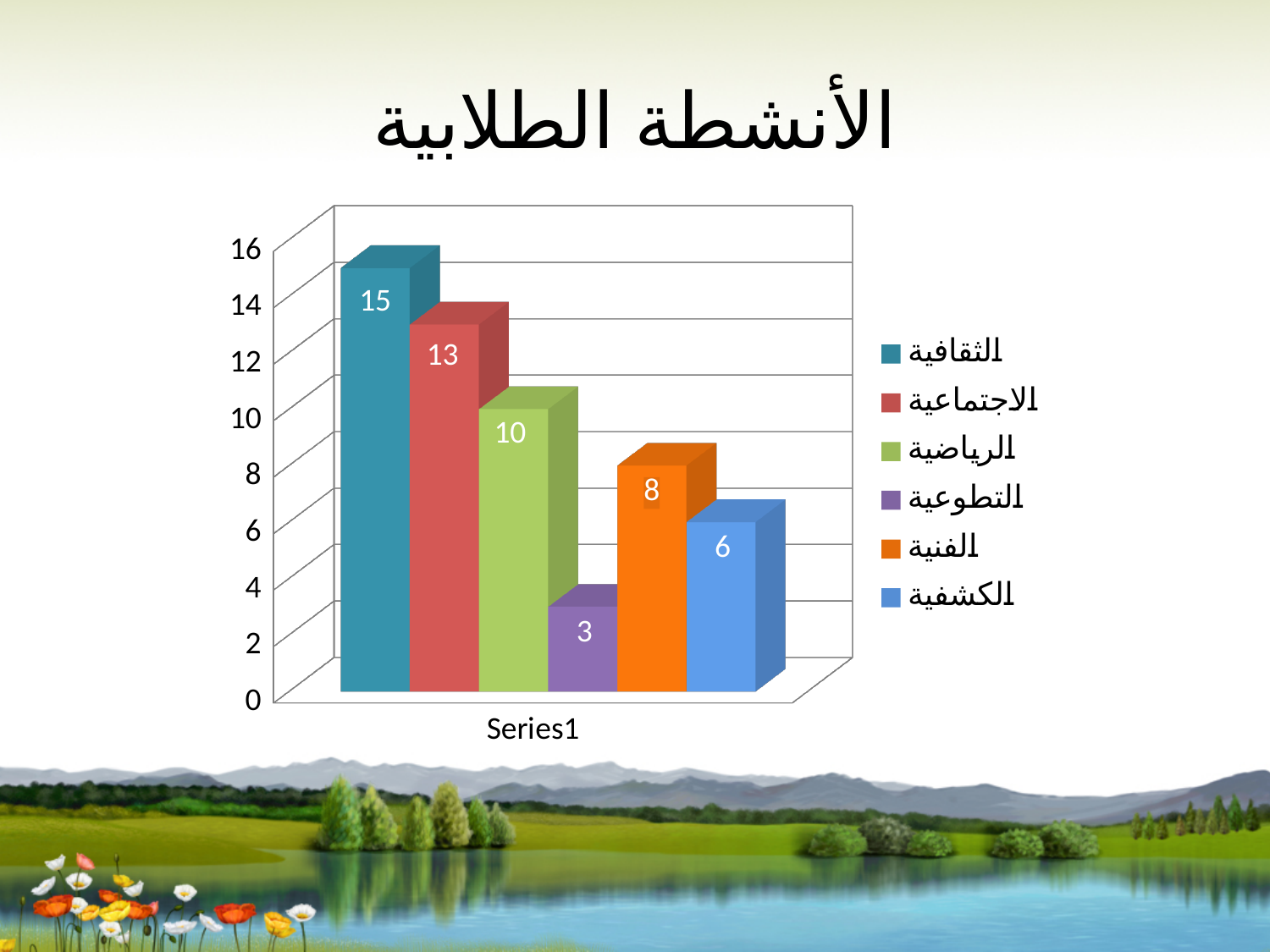
What value is shown for الكشفية? 6 What value is shown for الثقافية? 15 What is the title of the chart? الأنشطة الطلابية Is the value for الاجتماعية greater or less than 12? greater Which activity has the highest value? الثقافية What kind of chart is shown on the slide? bar chart What value is shown for الاجتماعية? 13 What value is shown for التطوعية? 3 Which activity has the lowest value? التطوعية What is the difference between the values for الثقافية and الرياضية? 5 How many bars are plotted in the chart? 6 Which is larger, the value for الفنية or the value for الكشفية? الفنية